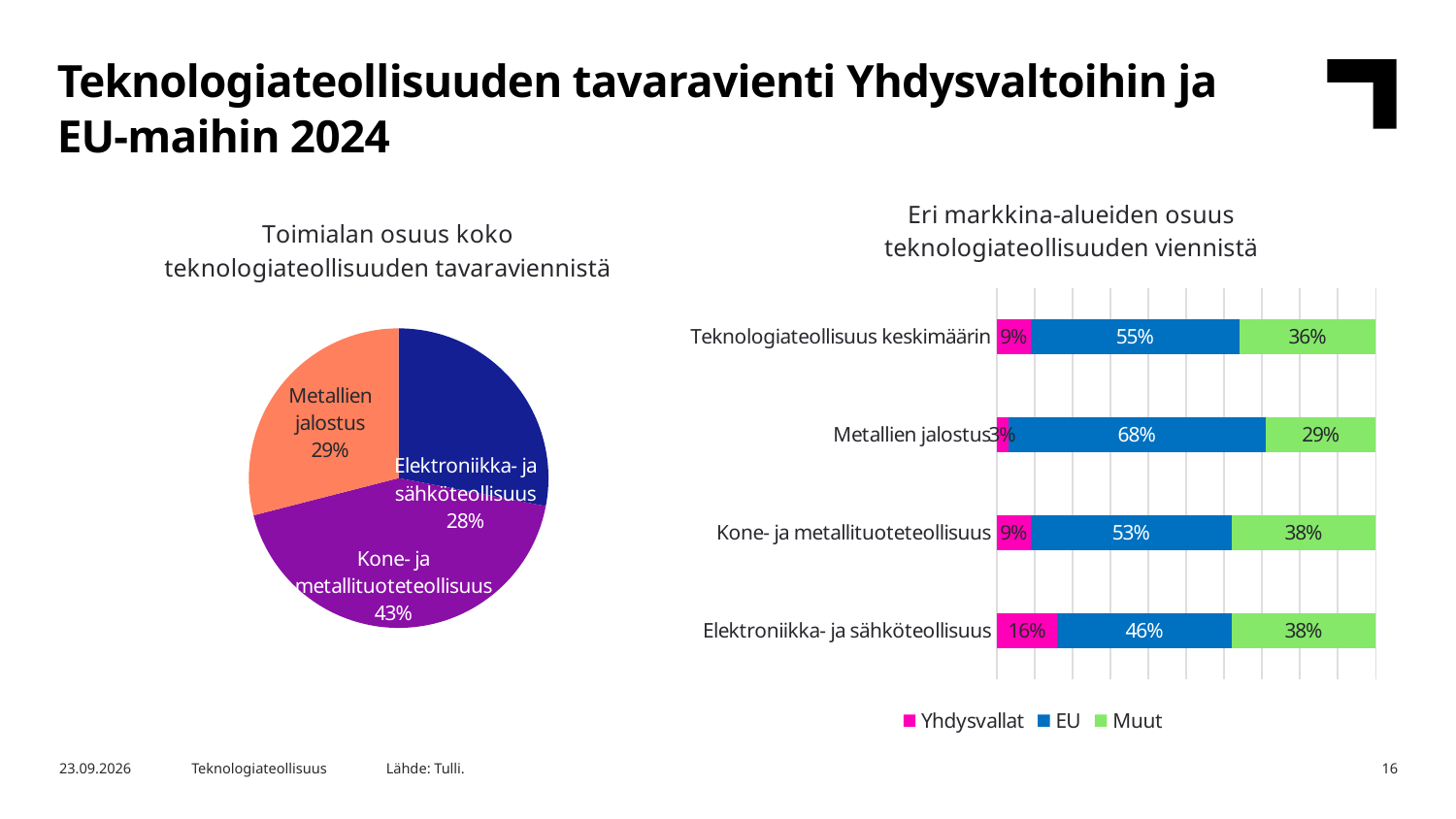
In the pie chart on the left, what share does Kone- ja metallituoteteollisuus have? 43% In the bar chart on the right, which category has the highest Yhdysvallat share? Elektroniikka- ja sähköteollisuus In the bar chart on the right, what is the EU share for Metallien jalostus? 68% In the bar chart on the right, what is the Yhdysvallat share for Elektroniikka- ja sähköteollisuus? 16% What type of chart is shown on the right side of the slide? Stacked bar chart In the pie chart on the left, what is the difference between the shares of Metallien jalostus and Elektroniikka- ja sähköteollisuus? 1 percentage point In the bar chart on the right, is the Muut share larger for Kone- ja metallituoteteollisuus or for Metallien jalostus? Kone- ja metallituoteteollisuus In the pie chart on the left, how many slices are there? 3 In the pie chart on the left, which sector has the largest share? Kone- ja metallituoteteollisuus In the bar chart on the right, what is the difference between the EU share for Metallien jalostus and the EU share for Teknologiateollisuus keskimäärin? 13 percentage points In the bar chart on the right, which category has the lowest EU share? Elektroniikka- ja sähköteollisuus In the bar chart on the right, how many series does the legend list? 3